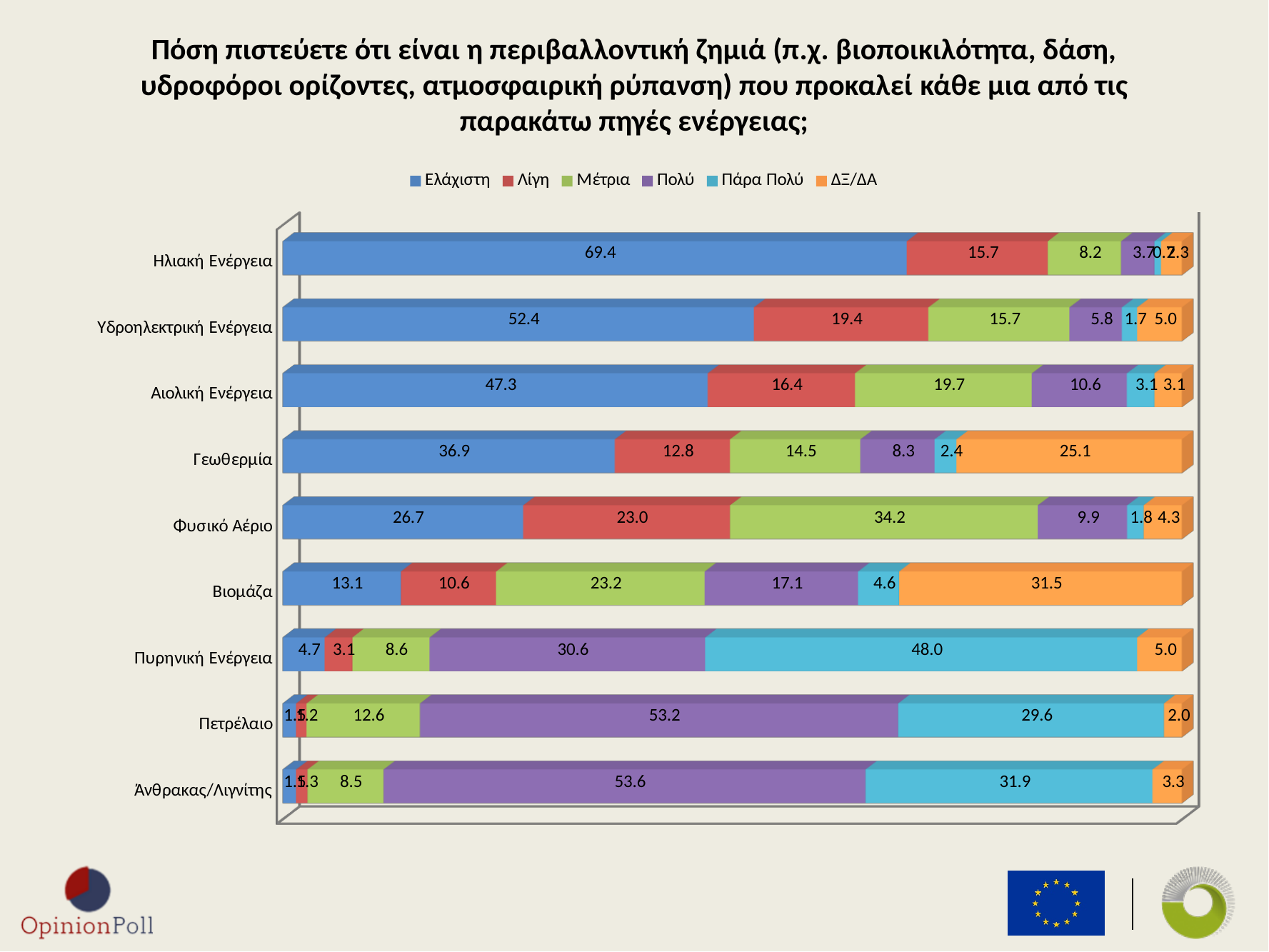
How many series does the legend list? 6 What kind of chart is shown on the slide? stacked bar chart What is the ΔΞ/ΔΑ value for Βιομάζα? 31.5 Which energy source has the highest Ελάχιστη value? Ηλιακή Ενέργεια Which energy source has the lowest Πολύ value? Ηλιακή Ενέργεια What is the Πάρα Πολύ value for Πυρηνική Ενέργεια? 48.0 Which is larger: the ΔΞ/ΔΑ value for Γεωθερμία or for Βιομάζα? Βιομάζα Which colour represents the Πάρα Πολύ series in the legend? light blue How many energy sources (categories) are shown on the chart? 9 What is the Μέτρια value for Φυσικό Αέριο? 34.2 What is the difference between the Πολύ values for Άνθρακας/Λιγνίτης and Πετρέλαιο? 0.4 What is the Ελάχιστη value for Ηλιακή Ενέργεια? 69.4